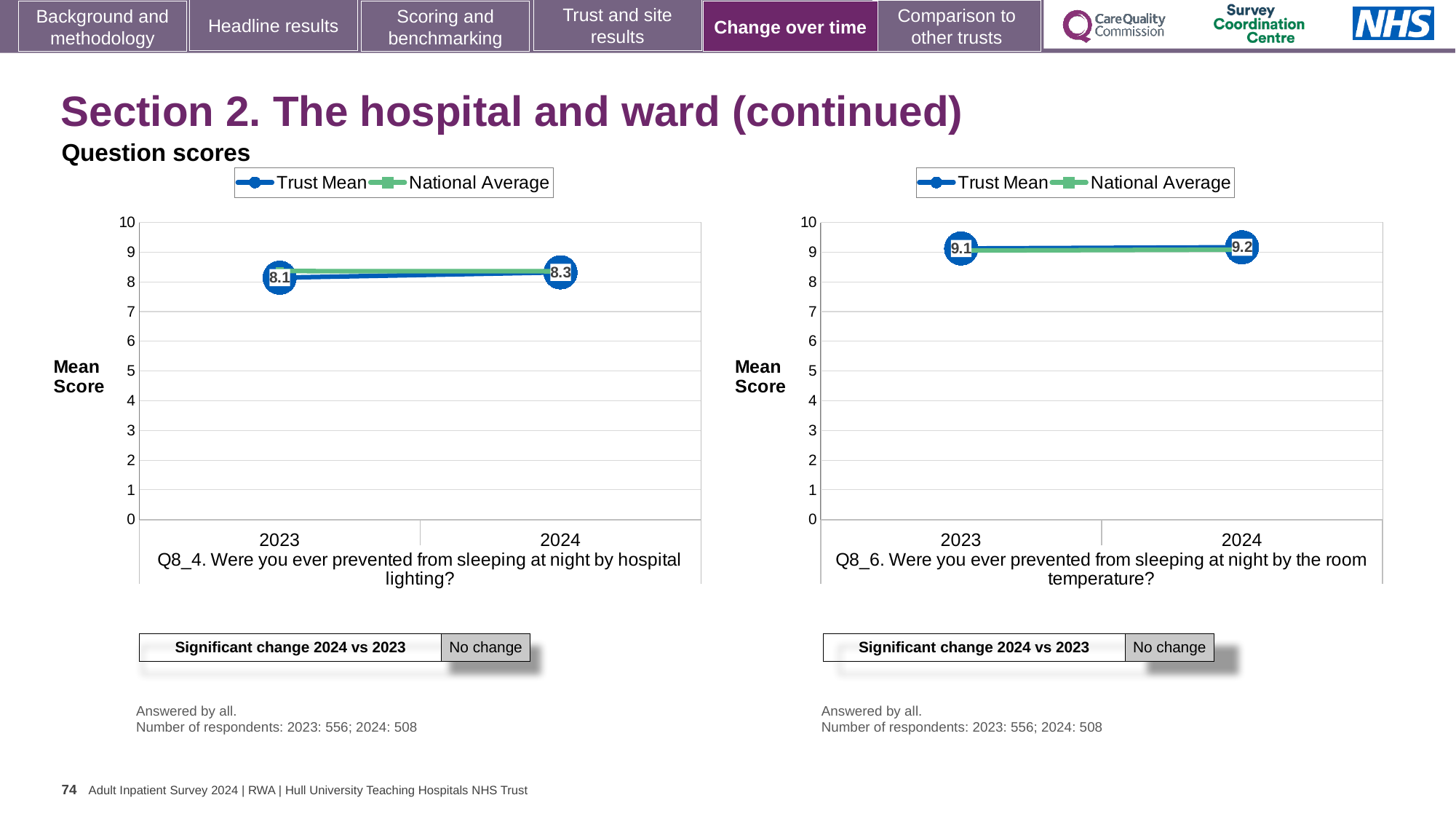
In the left chart (Q8_4), does the Trust Mean rise or fall from 2023 to 2024? rise How many series does the legend of the right chart (Q8_6) list? 2 In the right chart (Q8_6), what is the Trust Mean score for 2023? 9.1 In the right chart (Q8_6), is the National Average value for 2023 greater or less than 8? greater How many years are shown on the x axis of the left chart (Q8_4)? 2 Which is larger: the 2024 Trust Mean in the left chart (Q8_4) or the 2024 Trust Mean in the right chart (Q8_6)? Right chart (Q8_6), 9.2 In the left chart (Q8_4), what is the Trust Mean score for 2023? 8.1 In the right chart (Q8_6), what is the difference between the Trust Mean for 2024 and 2023? 0.1 In the right chart (Q8_6), what is the Trust Mean score for 2024? 9.2 What kind of chart is used for Q8_4 on the left? Line chart In the left chart (Q8_4), what is the Trust Mean score for 2024? 8.3 In the left chart (Q8_4), by how much did the Trust Mean change from 2023 to 2024? 0.2